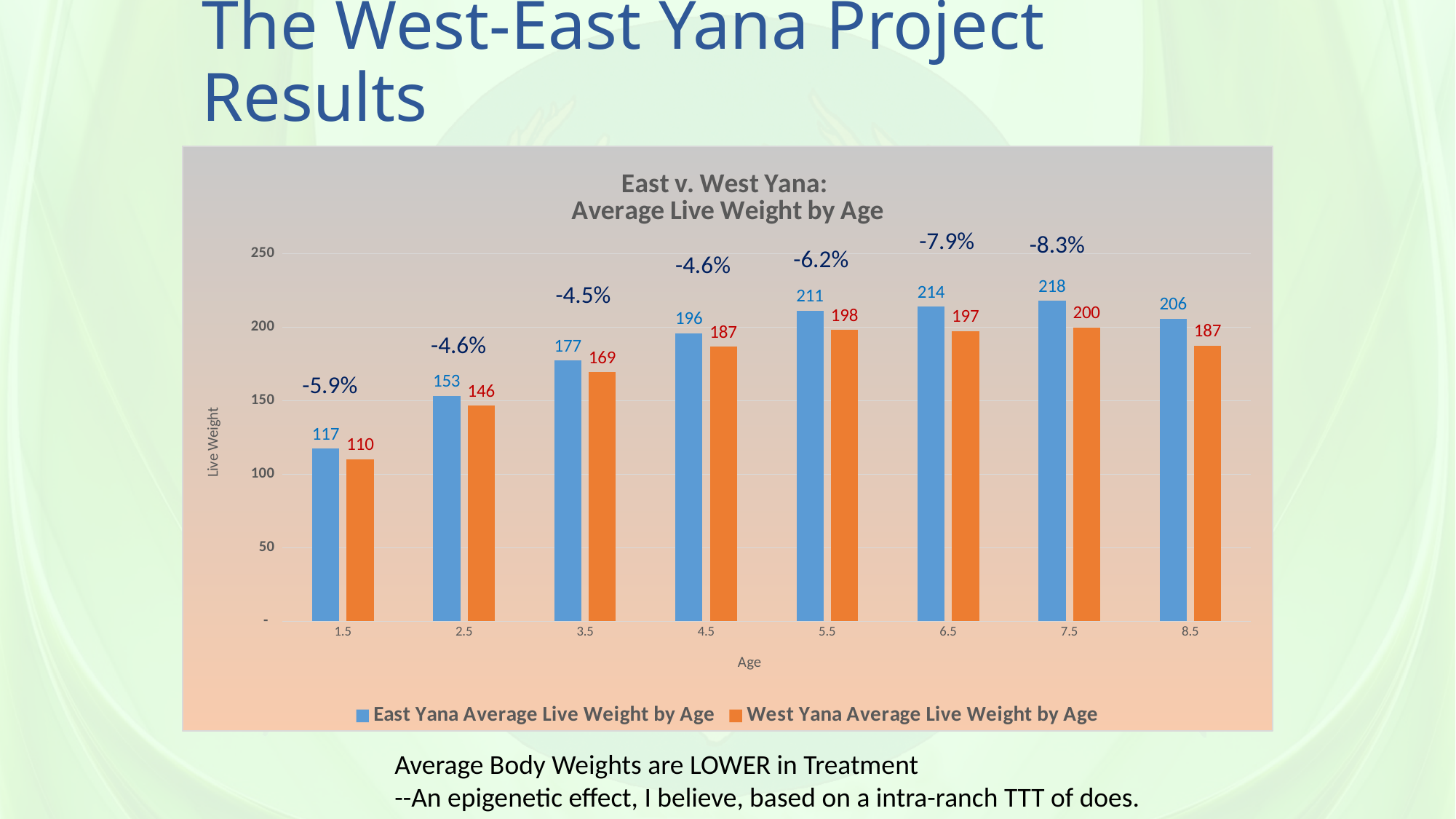
What is the East Yana average live weight at age 1.5? 117 How many series does the legend list? 2 What is the title of the chart? East v. West Yana: Average Live Weight by Age What is the difference between the East Yana and West Yana average live weights at age 8.5? 19 How many age categories are shown on the x axis? 8 Do the East Yana average live weights generally rise or fall from age 1.5 to age 7.5? Rise At which age is the West Yana average live weight lowest? 1.5 Which is larger at age 5.5: the East Yana or the West Yana average live weight? East Yana At which age is the East Yana average live weight highest? 7.5 What kind of chart is shown on the slide? Bar chart What is the West Yana average live weight at age 7.5? 200 What is the West Yana average live weight at age 3.5? 169